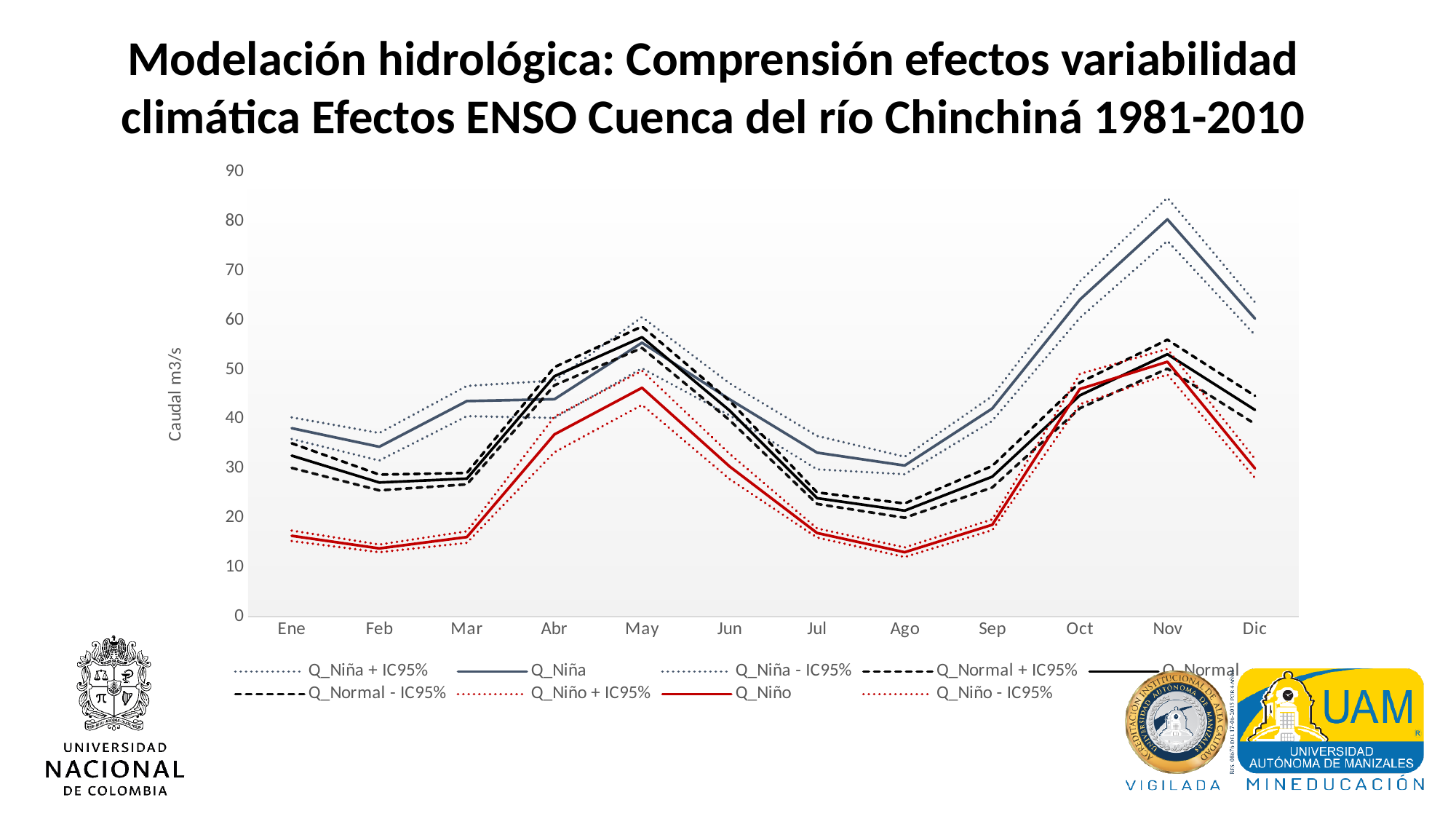
What kind of chart is shown on the slide? line chart Is the value of Q_Niño in Jul greater or less than 20? less Is the value of Q_Normal in Ene greater or less than 40? less In which month does the Q_Niño series reach its highest value? Nov What is the label of the vertical axis of the chart? Caudal m3/s In Nov, which series has the larger value, Q_Niña or Q_Niño? Q_Niña How many months are shown along the x axis of the chart? 12 In which month does the Q_Niña series reach its highest value? Nov How many series does the chart legend list? 9 Is the value of Q_Niña in Nov greater or less than 70? greater Does the Q_Niña series rise or fall from Sep to Nov? rise In which month does the Q_Normal series reach its highest value? May